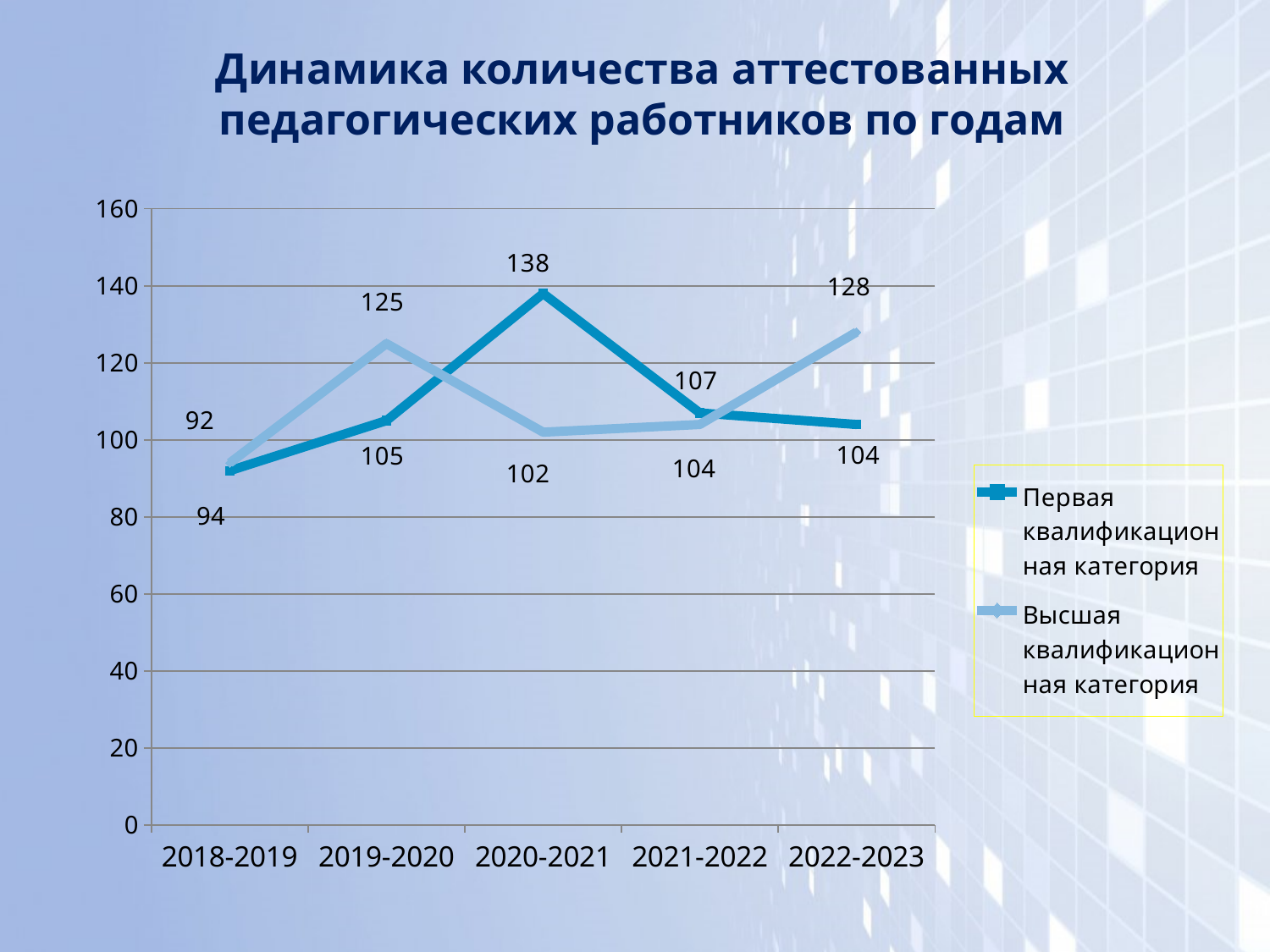
What type of chart is shown on the slide? Line chart In which year does Высшая квалификационная категория reach its highest value? 2022-2023 What is the value for Высшая квалификационная категория in 2022-2023? 128 What is the value for Первая квалификационная категория in 2020-2021? 138 In 2019-2020, which series has the larger value? Высшая квалификационная категория In which year does Первая квалификационная категория reach its highest value? 2020-2021 Does the value for Высшая квалификационная категория rise or fall from 2020-2021 to 2022-2023? Rise What is the value for Высшая квалификационная категория in 2019-2020? 125 How many series does the legend list? 2 How many academic years are shown on the x axis? 5 What is the value for Первая квалификационная категория in 2021-2022? 107 What is the difference between the Первая квалификационная категория values for 2020-2021 and 2021-2022? 31